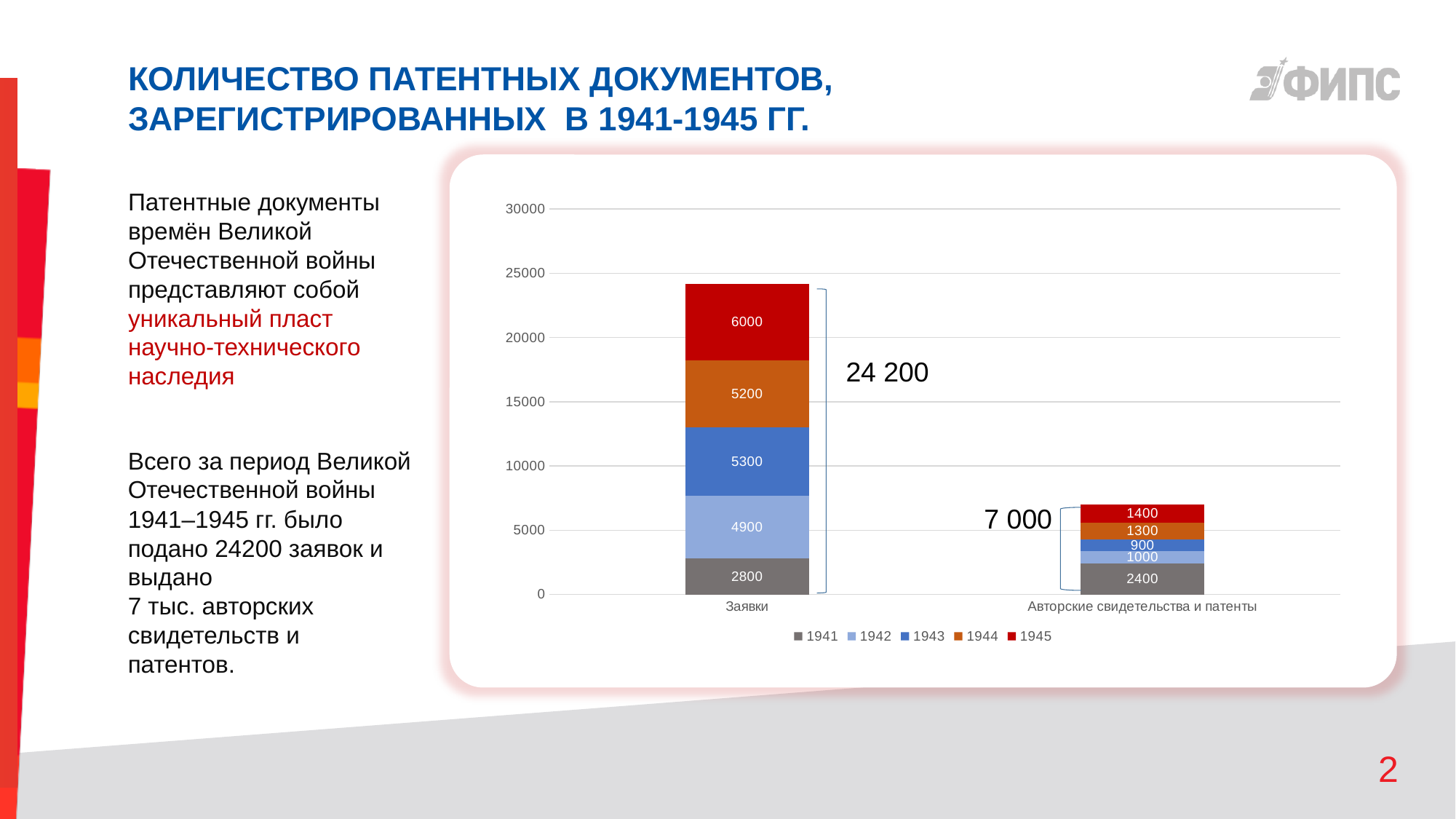
How many series does the chart legend list? 5 What is the total of the stacked bar for "Авторские свидетельства и патенты"? 7 000 How many categories are shown on the x axis of the chart? 2 What kind of chart is shown on the slide? Stacked bar chart Which year has the lowest value in the "Авторские свидетельства и патенты" bar? 1943 What is the value for 1941 in the "Авторские свидетельства и патенты" bar? 2400 What is the value for 1943 in the "Заявки" bar? 5300 What is the difference between the 1945 and 1941 values in the "Заявки" bar? 3200 Which is larger: the 1944 value for "Заявки" or the 1944 value for "Авторские свидетельства и патенты"? Заявки What is the value for 1945 in the "Заявки" bar? 6000 Which year has the highest value in the "Заявки" bar? 1945 What is the total of the stacked bar for "Заявки"? 24 200